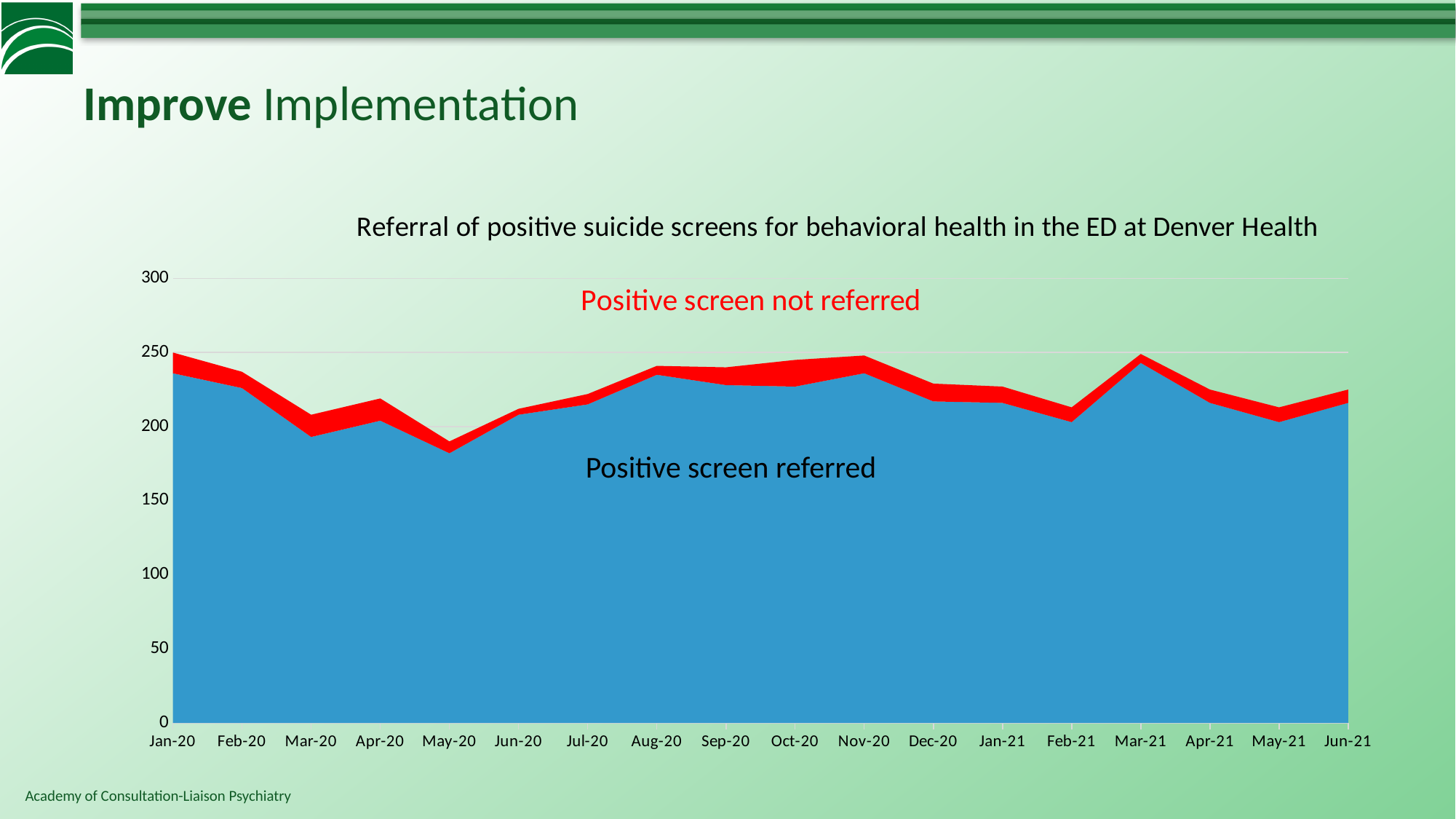
Which month has the larger 'Positive screen referred' value, Feb-20 or Mar-20? Feb-20 Do the 'Positive screen referred' values rise or fall from May-20 to Aug-20? Rise How many months are plotted along the x axis of the chart? 18 What is the title of the chart? Referral of positive suicide screens for behavioral health in the ED at Denver Health How many data series are shown in the chart? 2 In which month is the 'Positive screen referred' value highest? Mar-21 Is the 'Positive screen referred' value for May-20 greater or less than 200? less Is the 'Positive screen referred' value for Mar-21 greater or less than 200? greater Do the 'Positive screen referred' values rise or fall from Jan-20 to May-20? Fall In which month is the 'Positive screen referred' value lowest? May-20 What type of chart is shown on the slide? Area chart Which colour represents 'Positive screen not referred' in the chart? Red